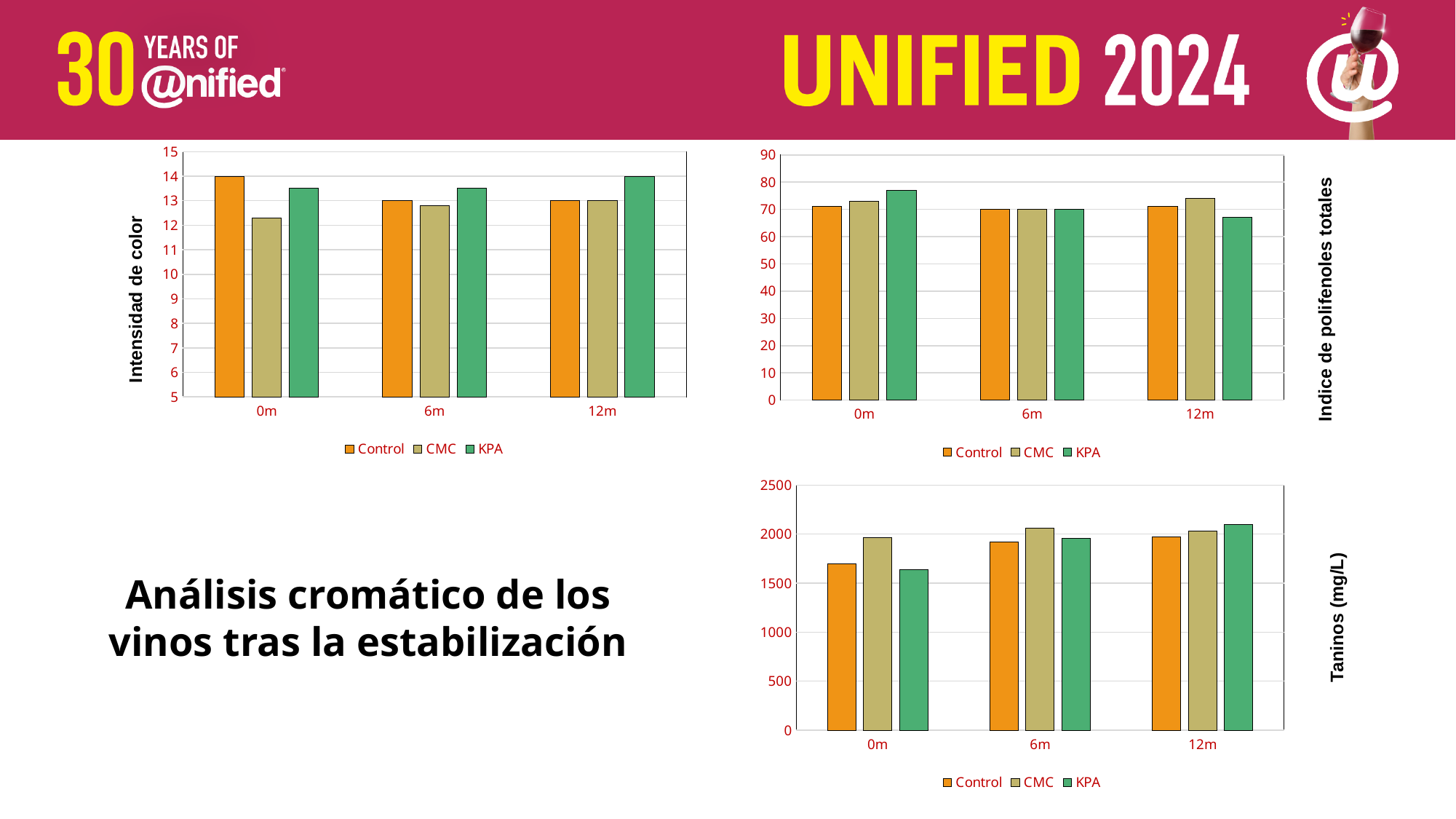
In the Intensidad de color chart, what is the value for Control at 0m? 14 In the Intensidad de color chart, which series has the lowest value at 0m? CMC In the Indice de polifenoles totales chart, which series has the lowest value at 12m? KPA In the Intensidad de color chart, which series has the highest value at 12m? KPA In the Taninos (mg/L) chart, which series has the highest value at 0m? CMC In the Indice de polifenoles totales chart, which series has the highest value at 0m? KPA In the Indice de polifenoles totales chart, is the value for KPA at 12m greater or less than 70? less What kind of chart is the Intensidad de color chart? bar chart In the Taninos (mg/L) chart, is the value for Control at 0m greater or less than 2000? less How many series does the legend of the Taninos (mg/L) chart list? 3 In the Intensidad de color chart, is the value for CMC at 0m greater or less than 13? less